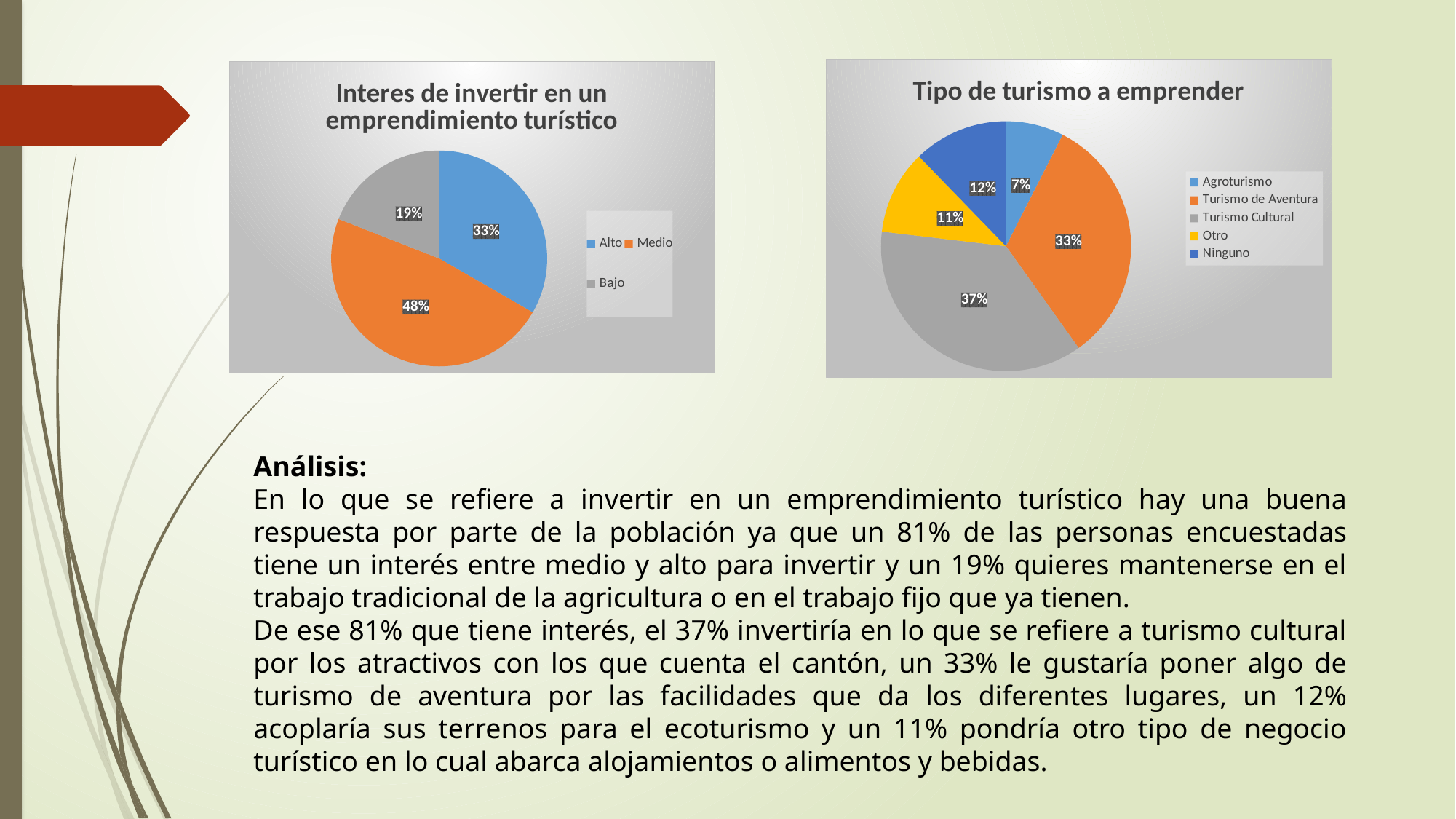
In the chart titled 'Tipo de turismo a emprender', which is larger, Otro or Ninguno? Ninguno In the chart titled 'Interes de invertir en un emprendimiento turístico', how many categories does the legend list? 3 In the chart titled 'Tipo de turismo a emprender', what colour is the Otro slice? Yellow In the chart titled 'Interes de invertir en un emprendimiento turístico', what share is labelled for Bajo? 19% In the chart titled 'Tipo de turismo a emprender', what share is labelled for Agroturismo? 7% What kind of chart is the one titled 'Tipo de turismo a emprender'? Pie chart In the chart titled 'Tipo de turismo a emprender', what share is labelled for Turismo Cultural? 37% In the chart titled 'Interes de invertir en un emprendimiento turístico', what share is labelled for Medio? 48% In the chart titled 'Interes de invertir en un emprendimiento turístico', which category has the largest slice? Medio In the chart titled 'Tipo de turismo a emprender', which category has the smallest slice? Agroturismo In the chart titled 'Interes de invertir en un emprendimiento turístico', what is the difference between the Medio and Alto shares? 15% In the chart titled 'Tipo de turismo a emprender', how many categories does the legend list? 5